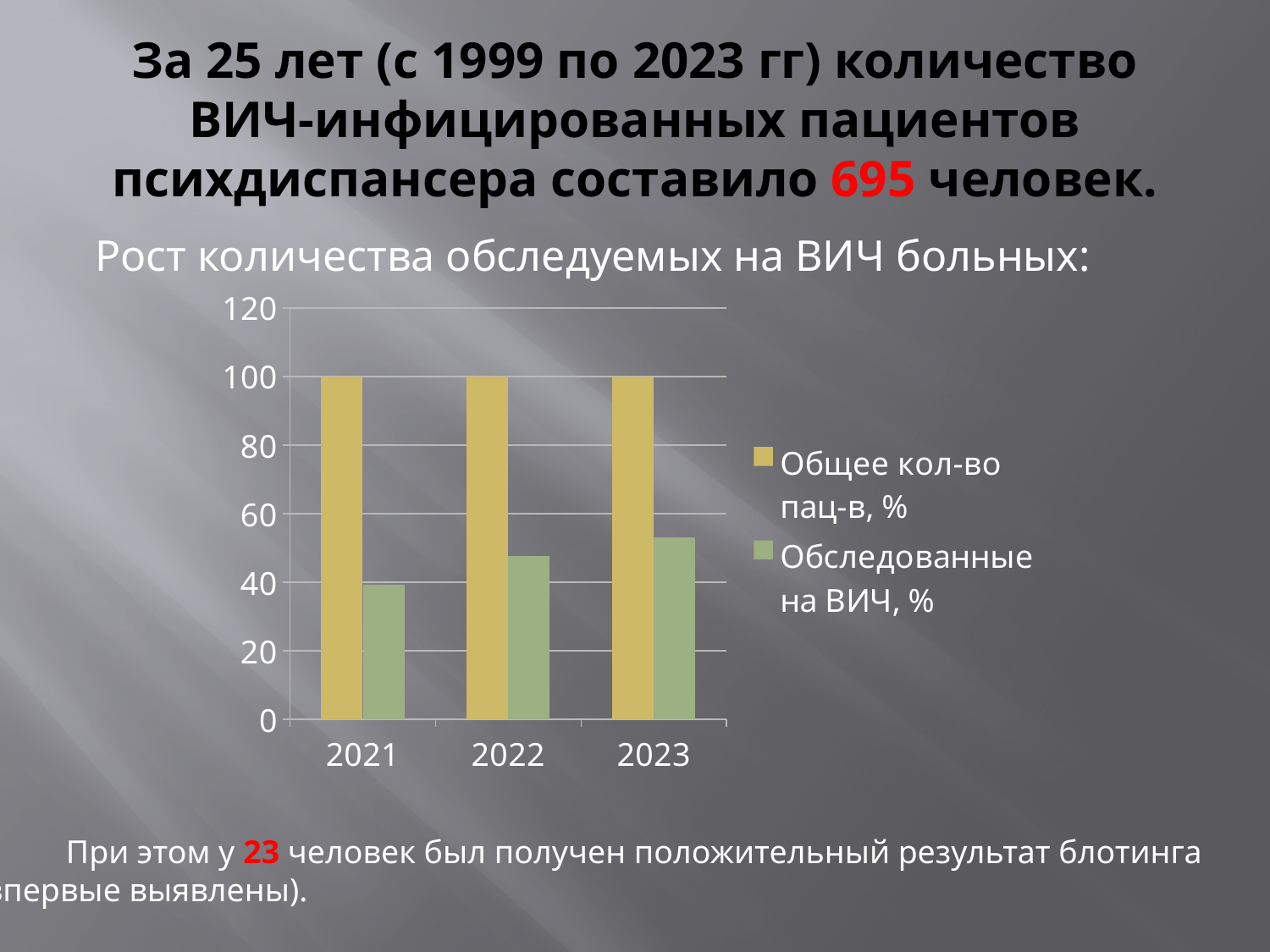
Does the value of "Обследованные на ВИЧ, %" rise or fall from 2021 to 2023? rise Is the value of "Обследованные на ВИЧ, %" for 2023 greater or less than 60? less In which year is the value of "Обследованные на ВИЧ, %" highest? 2023 What is the value of "Общее кол-во пац-в, %" for 2022? 100 In which year is the value of "Обследованные на ВИЧ, %" lowest? 2021 How many series does the chart legend list? 2 What kind of chart is shown on the slide? bar chart Is the value of "Обследованные на ВИЧ, %" for 2022 greater or less than 40? greater Is the value of "Обследованные на ВИЧ, %" for 2021 greater or less than 60? less How many years are shown on the x axis of the chart? 3 What is the value of "Общее кол-во пац-в, %" for 2023? 100 Which series is shown in green in the chart? Обследованные на ВИЧ, %